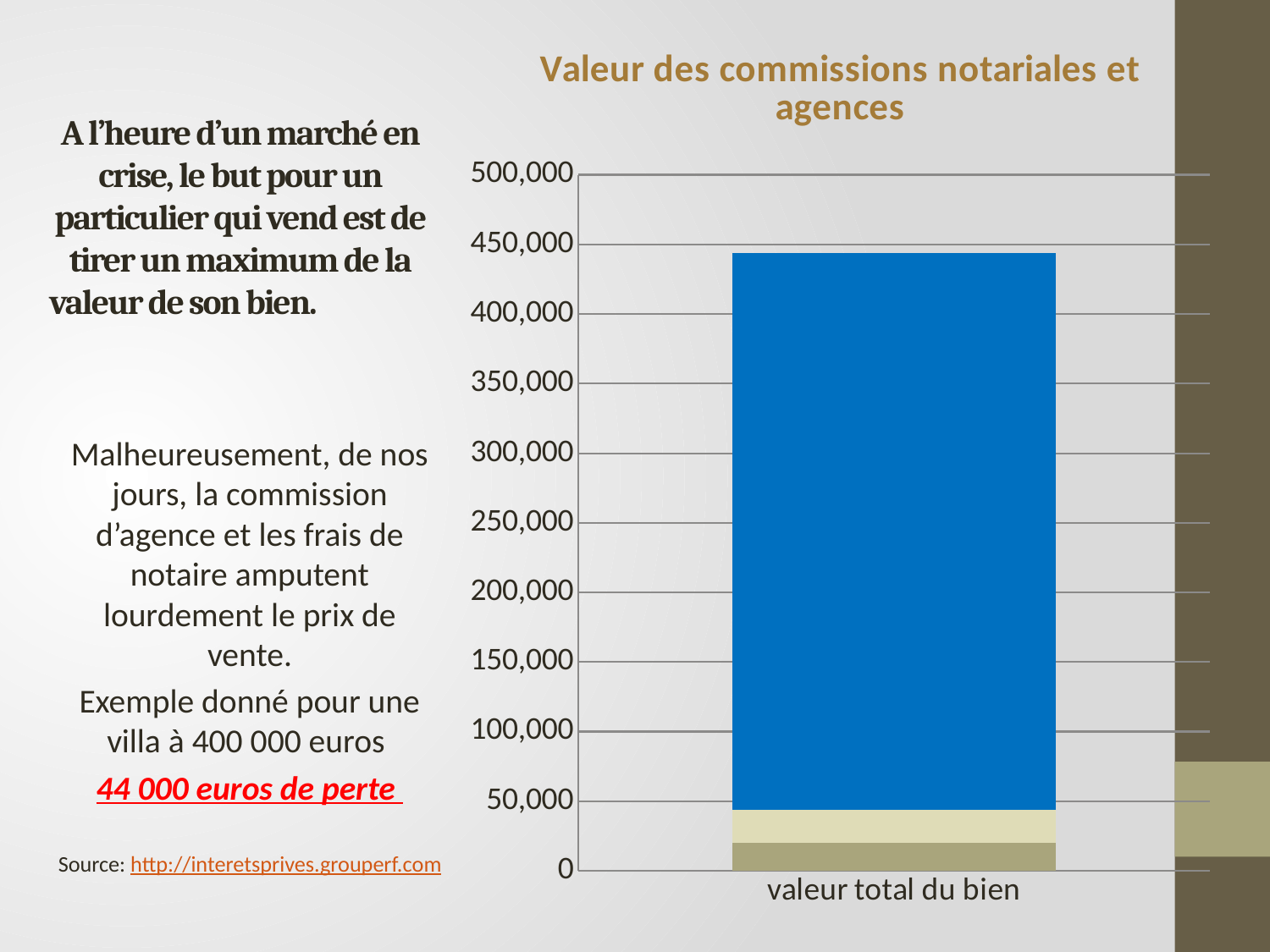
What kind of chart is shown on the slide? bar chart What is the title of the chart? Valeur des commissions notariales et agences Which colour segment of the stacked bar is the largest? blue Is the total height of the stacked bar for 'valeur total du bien' greater or less than 400,000? greater What is the label of the category on the x axis? valeur total du bien How many categories are shown on the x axis of the chart? 1 Is the total height of the stacked bar for 'valeur total du bien' greater or less than 450,000? less Is the combined height of the two bottom (non-blue) segments of the bar greater or less than 50,000? less What is the highest value shown on the y axis? 500,000